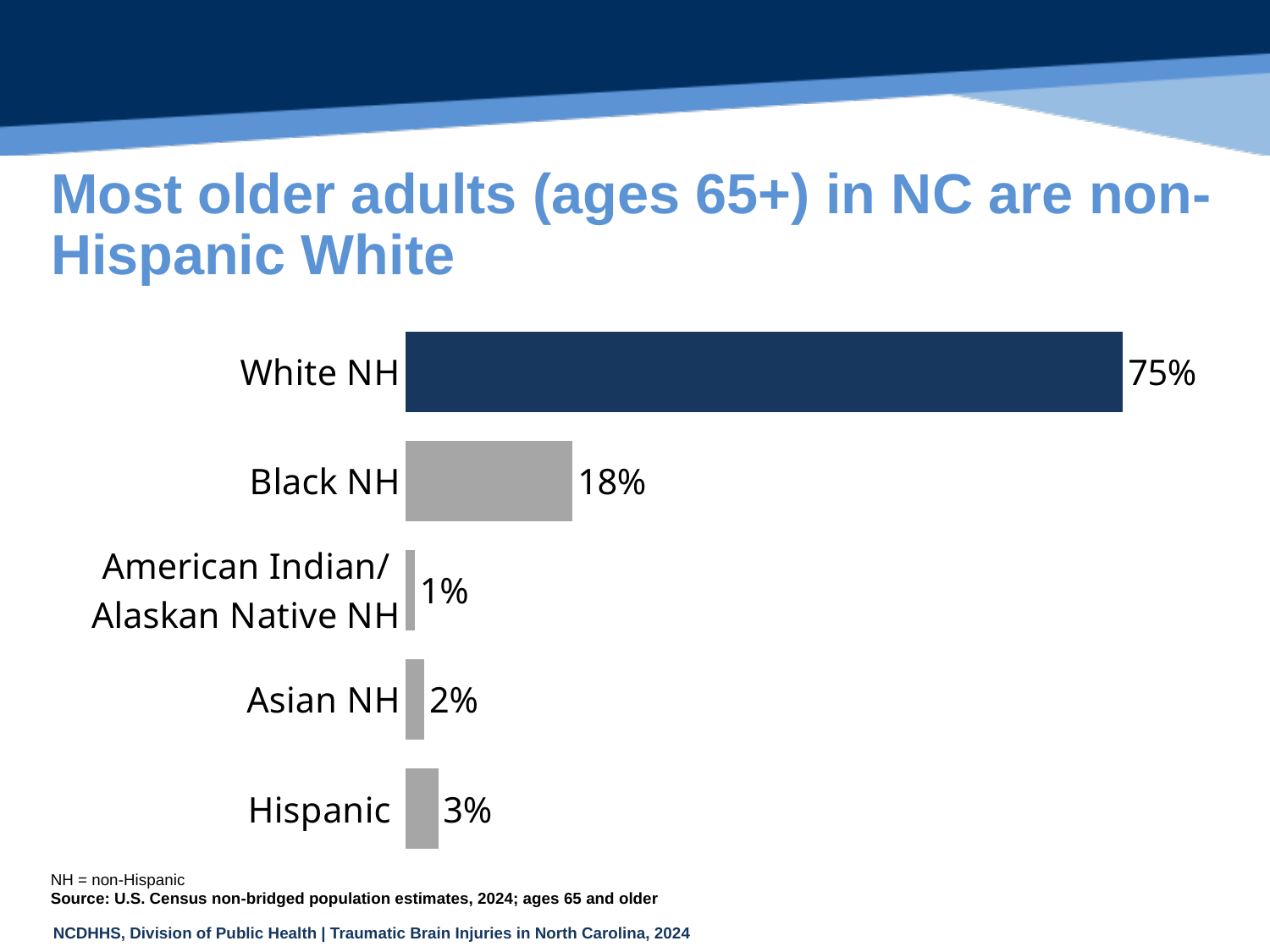
What kind of chart is shown on the slide? Bar chart What percentage of older adults in NC are White NH? 75% What is the difference between the White NH and Black NH values? 57% What is the value shown for Asian NH? 2% What is the value shown for Hispanic? 3% How many categories are shown in the chart? 5 Which is larger, the value for Hispanic or the value for Asian NH? Hispanic Which category has the highest value? White NH Which bar is shown in dark blue rather than grey? White NH Which category has the lowest value? American Indian/Alaskan Native NH What percentage of older adults in NC are Black NH? 18% What is the value shown for American Indian/Alaskan Native NH? 1%